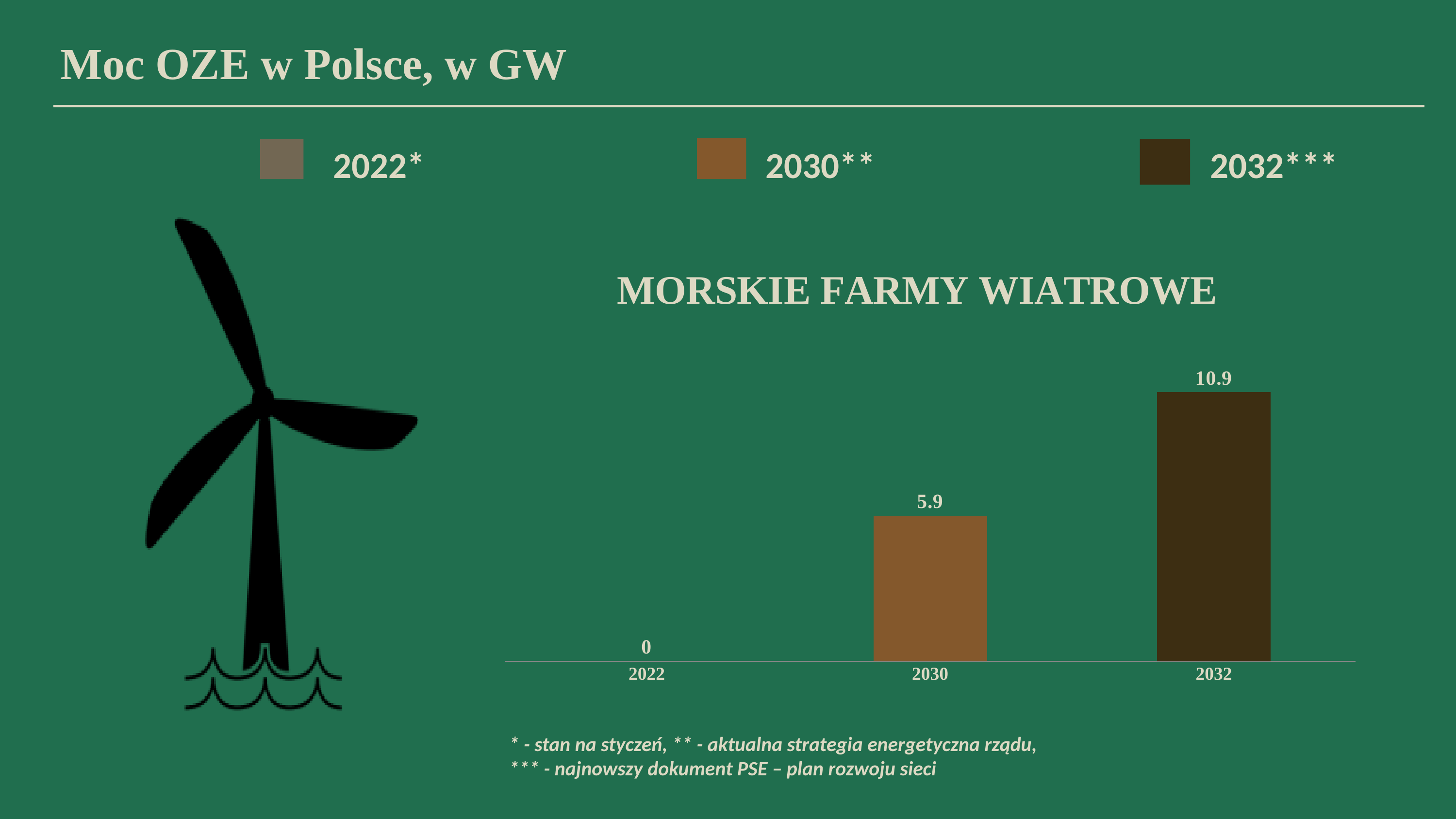
How many entries does the legend above the chart list? 3 What is the value for 2030 in the Morskie Farmy Wiatrowe chart? 5.9 What is the difference between the 2032 and 2030 values in the Morskie Farmy Wiatrowe chart? 5 What is the title of the slide? Moc OZE w Polsce, w GW What is the value for 2032 in the Morskie Farmy Wiatrowe chart? 10.9 Which year has the highest value in the Morskie Farmy Wiatrowe chart? 2032 What is the value for 2022 in the Morskie Farmy Wiatrowe chart? 0 How many years are shown on the x axis of the Morskie Farmy Wiatrowe chart? 3 Which is larger in the Morskie Farmy Wiatrowe chart, the value for 2030 or the value for 2032? 2032 Which year has the lowest value in the Morskie Farmy Wiatrowe chart? 2022 What kind of chart is the Morskie Farmy Wiatrowe chart? bar chart Do the values in the Morskie Farmy Wiatrowe chart rise or fall from 2022 to 2032? rise